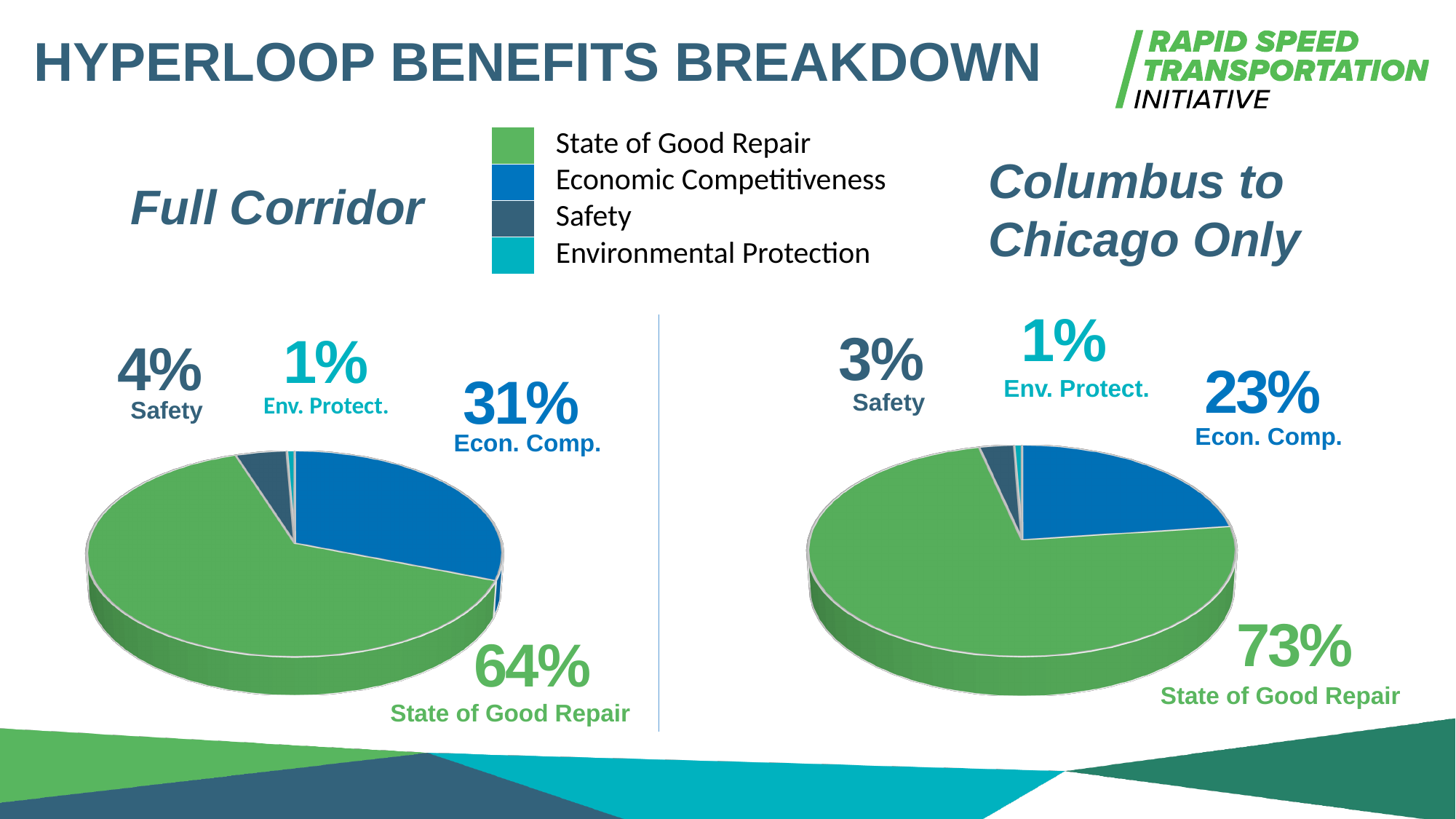
Which colour represents Safety in the legend? Dark blue In the Columbus to Chicago Only pie chart, which category has the smallest share? Environmental Protection What is the difference between the State of Good Repair share in the Columbus to Chicago Only chart and in the Full Corridor chart? 9 percentage points In the Full Corridor pie chart, what share is Safety? 4% How many entries does the legend list? 4 In the Columbus to Chicago Only pie chart, what share is Environmental Protection? 1% What type of chart is used on this slide? Pie chart How many categories does each pie chart show? 4 In the Full Corridor pie chart, what share is State of Good Repair? 64% In the Full Corridor pie chart, which category has the largest share? State of Good Repair In the Columbus to Chicago Only pie chart, what share is Economic Competitiveness (Econ. Comp.)? 23% Is the Econ. Comp. share larger in the Full Corridor chart or the Columbus to Chicago Only chart? Full Corridor